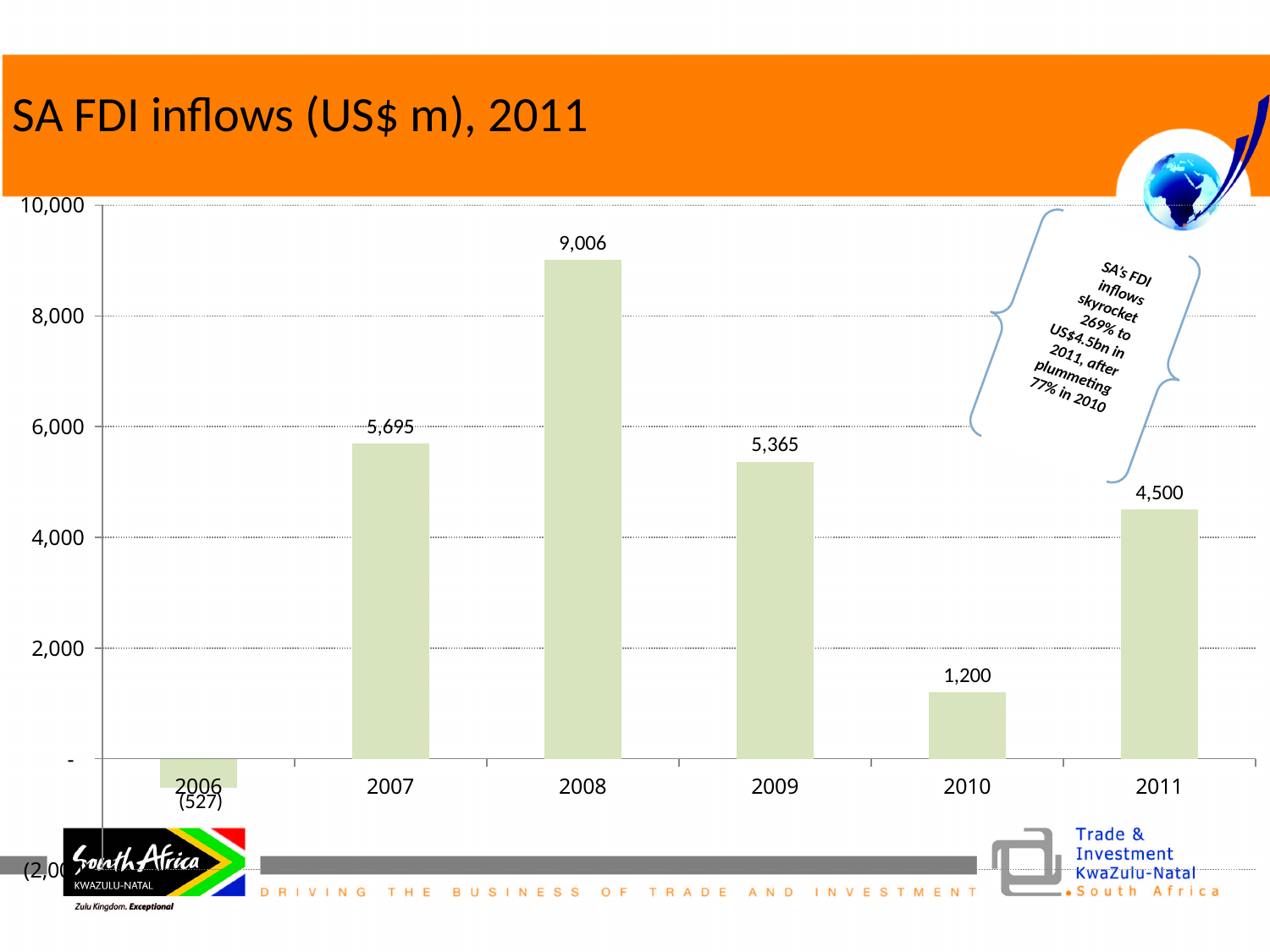
What is the difference between the values for 2008 and 2009? 3,641 What is the value for 2008? 9,006 What is the title of the chart? SA FDI inflows (US$ m), 2011 What is the value shown for 2006? (527) What is the difference between the values for 2011 and 2010? 3,300 How many years are shown on the x axis? 6 Which is larger, the value for 2007 or the value for 2009? 2007 Which year has the lowest FDI inflow? 2006 What is the value for 2011? 4,500 Which year has the highest FDI inflow? 2008 What is the value for 2010? 1,200 What kind of chart is shown on the slide? Bar chart